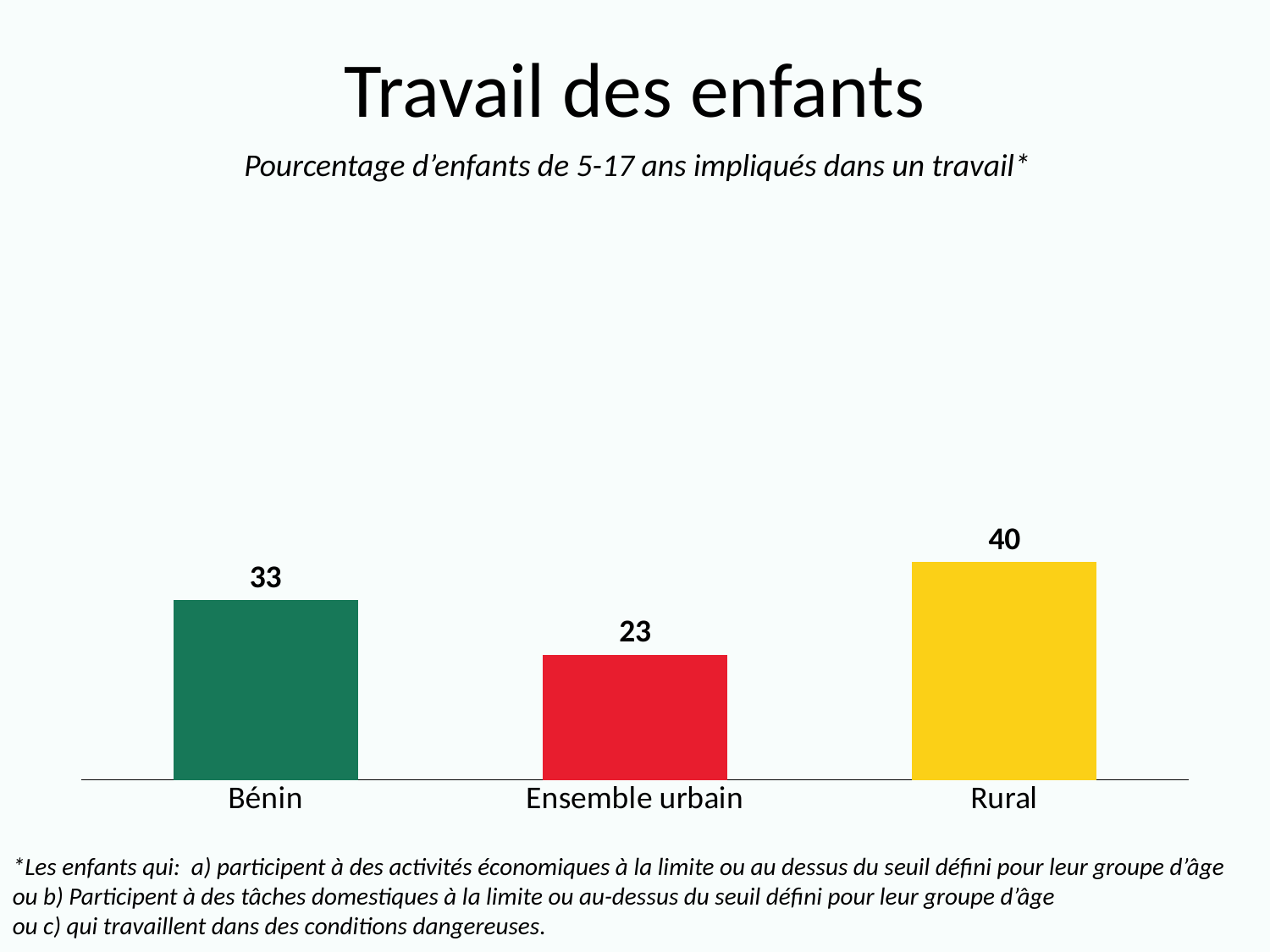
How many categories are shown in the chart? 3 What is the difference between the values for Rural and Ensemble urbain? 17 What is the title of the slide? Travail des enfants What is the value for Ensemble urbain? 23 Which category has the lowest value? Ensemble urbain What is the difference between the values for Rural and Bénin? 7 What is the value for Bénin? 33 Which is larger, the value for Bénin or the value for Ensemble urbain? Bénin Which category has the highest value? Rural What is the value for Rural? 40 What colour is the bar for Rural? Yellow What kind of chart is shown on the slide? Bar chart